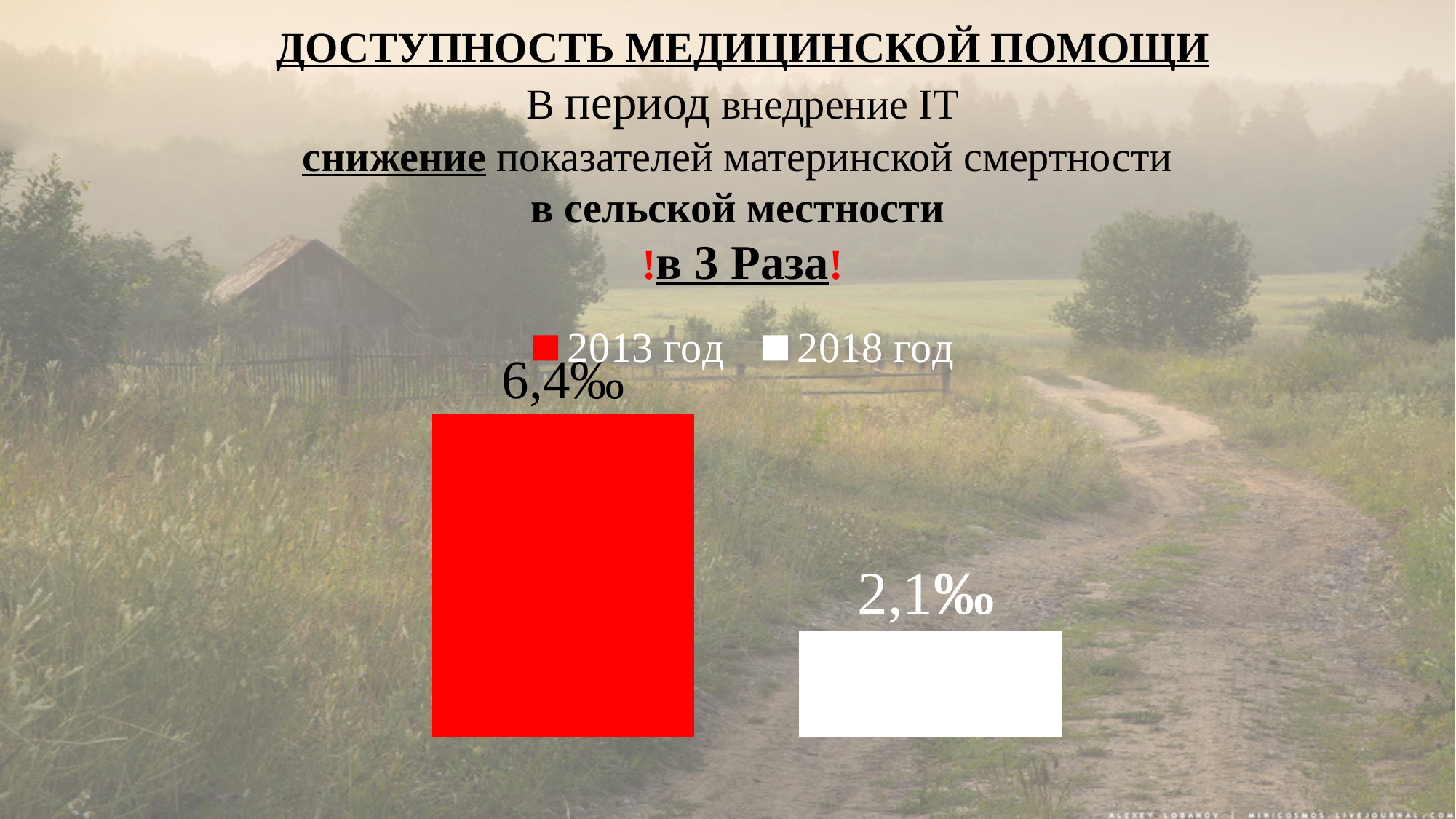
How many bars are plotted on the chart? 2 What colour is the bar for 2018 год? white What colour is the bar for 2013 год? red What is the value shown for 2018 год? 2,1‰ What kind of chart is shown on the slide? bar chart How many series does the legend list? 2 What is the value shown for 2013 год? 6,4‰ Which series has the highest value? 2013 год Which series has the lowest value? 2018 год Which year has the higher value, 2013 год or 2018 год? 2013 год What is the difference between the 2013 год value and the 2018 год value? 4,3‰ Do the values rise or fall from 2013 год to 2018 год? fall